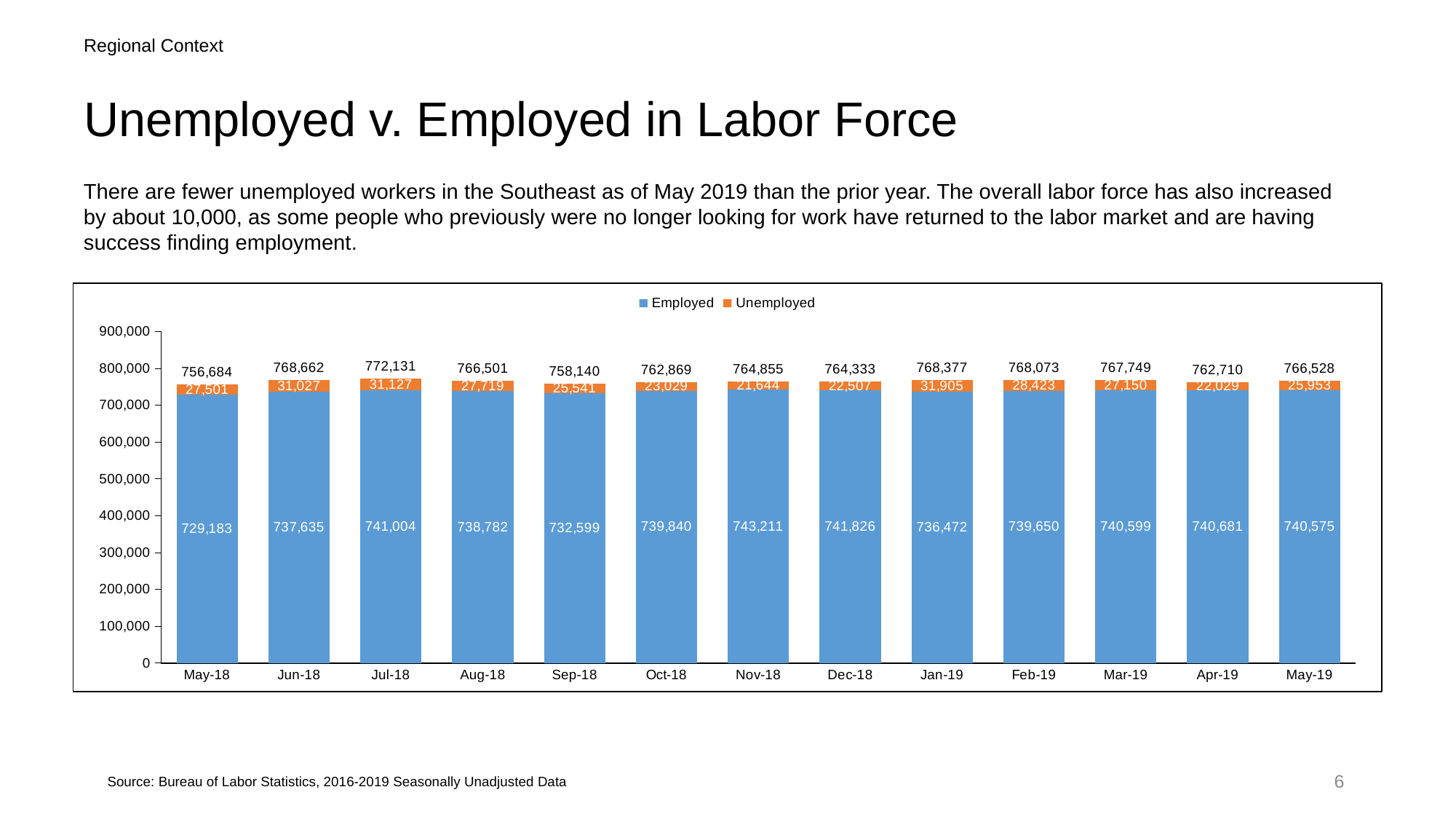
What kind of chart is shown on the slide? Stacked bar chart Which is larger, the Employed value for Jun-18 or for Sep-18? Jun-18 Is the total bar height for Dec-18 greater or less than 700,000? greater What is the Unemployed value for Jan-19? 31,905 What is the difference between the Unemployed value for May-18 and May-19? 1,548 What is the Employed value for Nov-18? 743,211 Which month has the lowest Employed value? May-18 How many months are shown on the x axis? 13 How many series does the legend list? 2 Which month has the highest Unemployed value? Jan-19 What is the total labor force shown above the bar for Jul-18? 772,131 Which month has the lowest Unemployed value? Nov-18